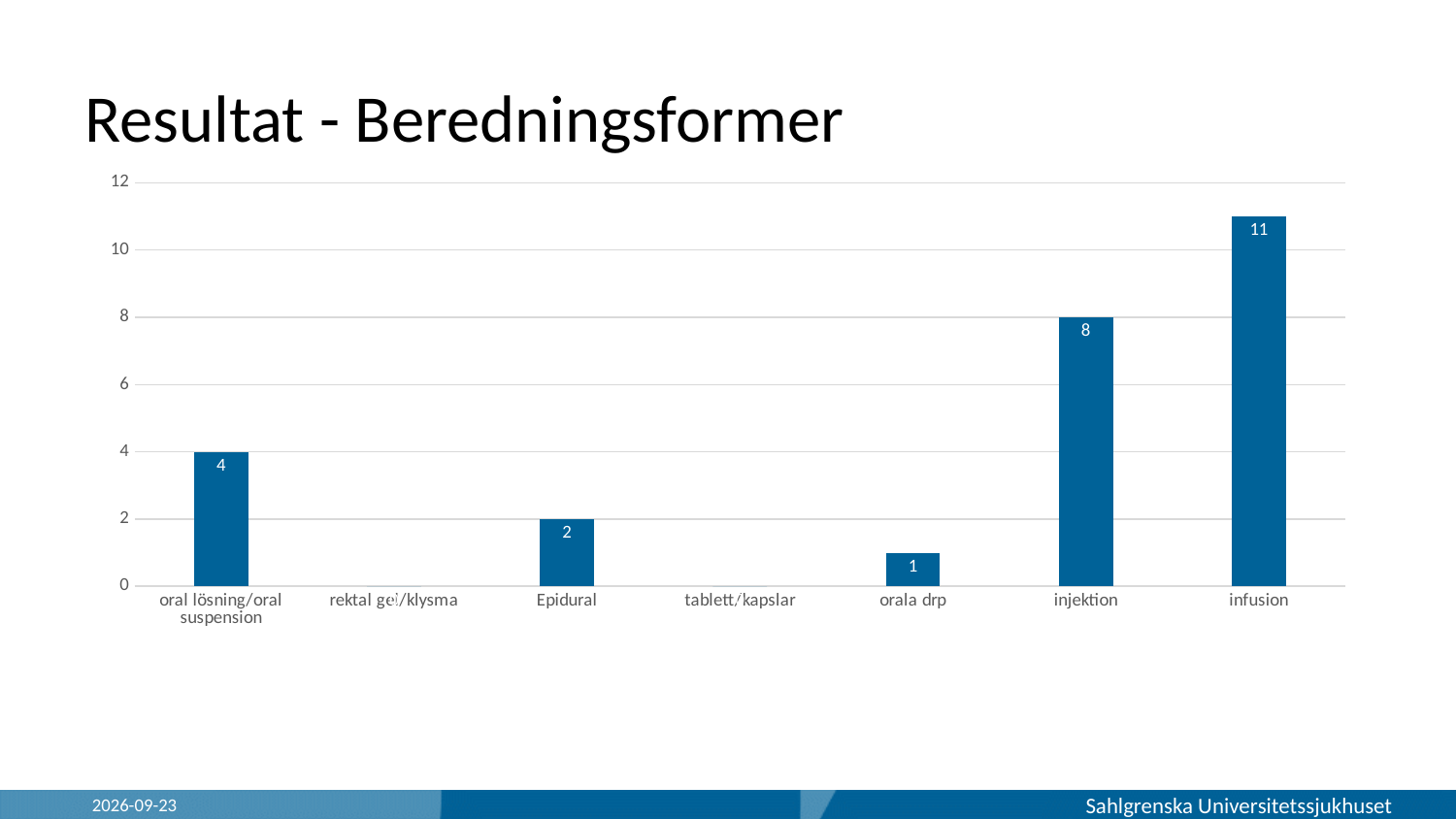
What is the value for infusion? 11 What is the value for injektion? 8 Which category has the highest value? infusion What is the difference between the values for oral lösning/oral suspension and Epidural? 2 Which is larger, the value for injektion or the value for oral lösning/oral suspension? injektion How many categories are shown on the x axis? 7 What is the value for Epidural? 2 What kind of chart is shown on the slide? bar chart What is the value for oral lösning/oral suspension? 4 What is the difference between the values for infusion and injektion? 3 Is the value for infusion greater or less than 10? greater What is the value for orala drp? 1